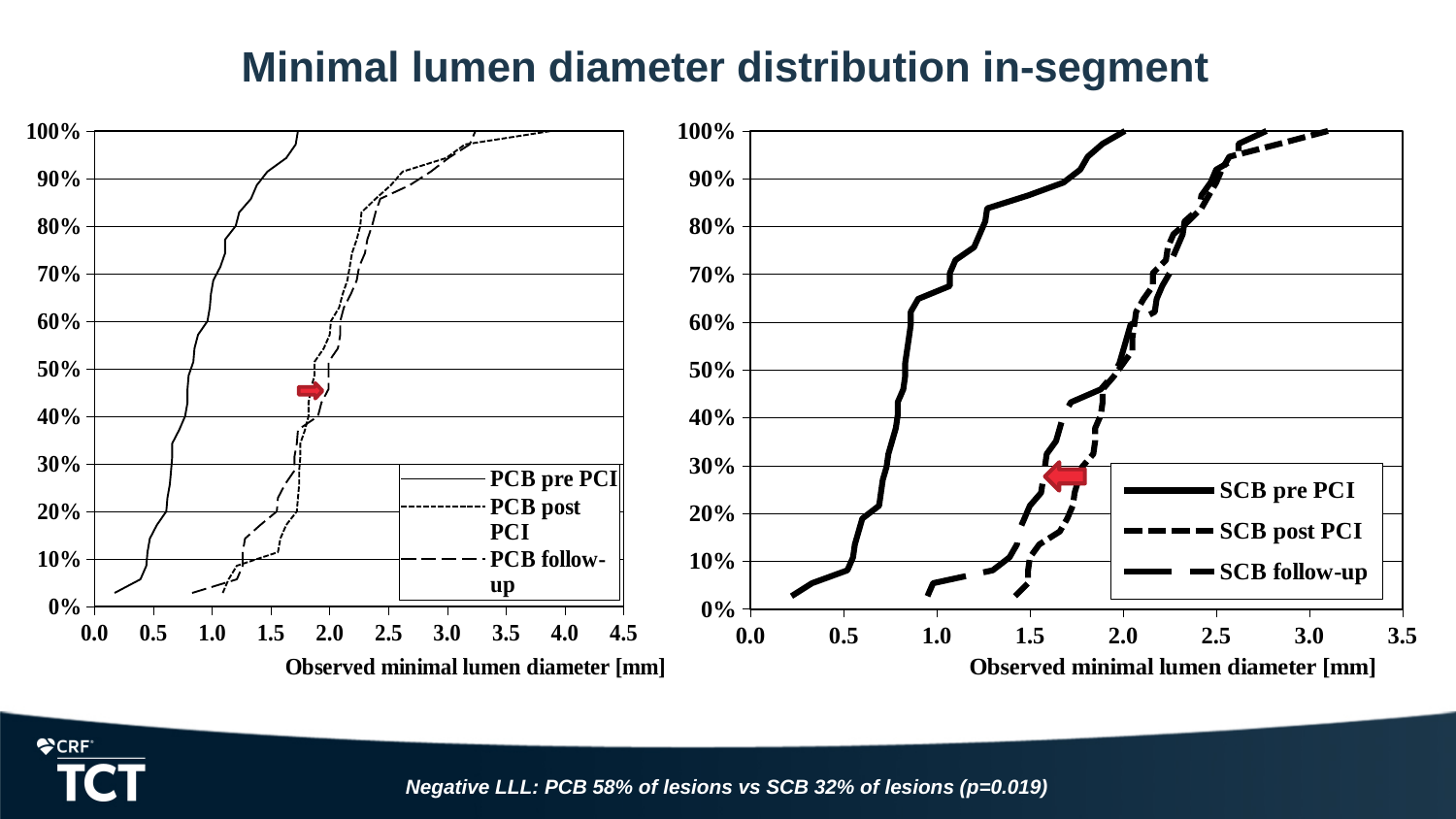
In the left chart, is the diameter at which the PCB post PCI curve reaches 100% greater or less than 3.0 mm? greater What kind of chart is the left chart on the slide? line chart How many series does the legend of the right chart list? 3 In the right chart, is the diameter at which the SCB pre PCI curve crosses 50% greater or less than 1.0 mm? less In the left chart, which series lies at the smallest diameters, PCB pre PCI or PCB post PCI? PCB pre PCI How many series does the legend of the left chart list? 3 What is the x-axis label of the left chart? Observed minimal lumen diameter [mm] In the left chart, is the diameter at which the PCB pre PCI curve reaches 100% greater or less than 2.0 mm? less In the right chart, what are the three series named in the legend? SCB pre PCI, SCB post PCI, SCB follow-up In the right chart, which series reaches 100% at a smaller diameter, SCB pre PCI or SCB follow-up? SCB pre PCI In the left chart, do the curves rise or fall as the observed minimal lumen diameter increases? rise